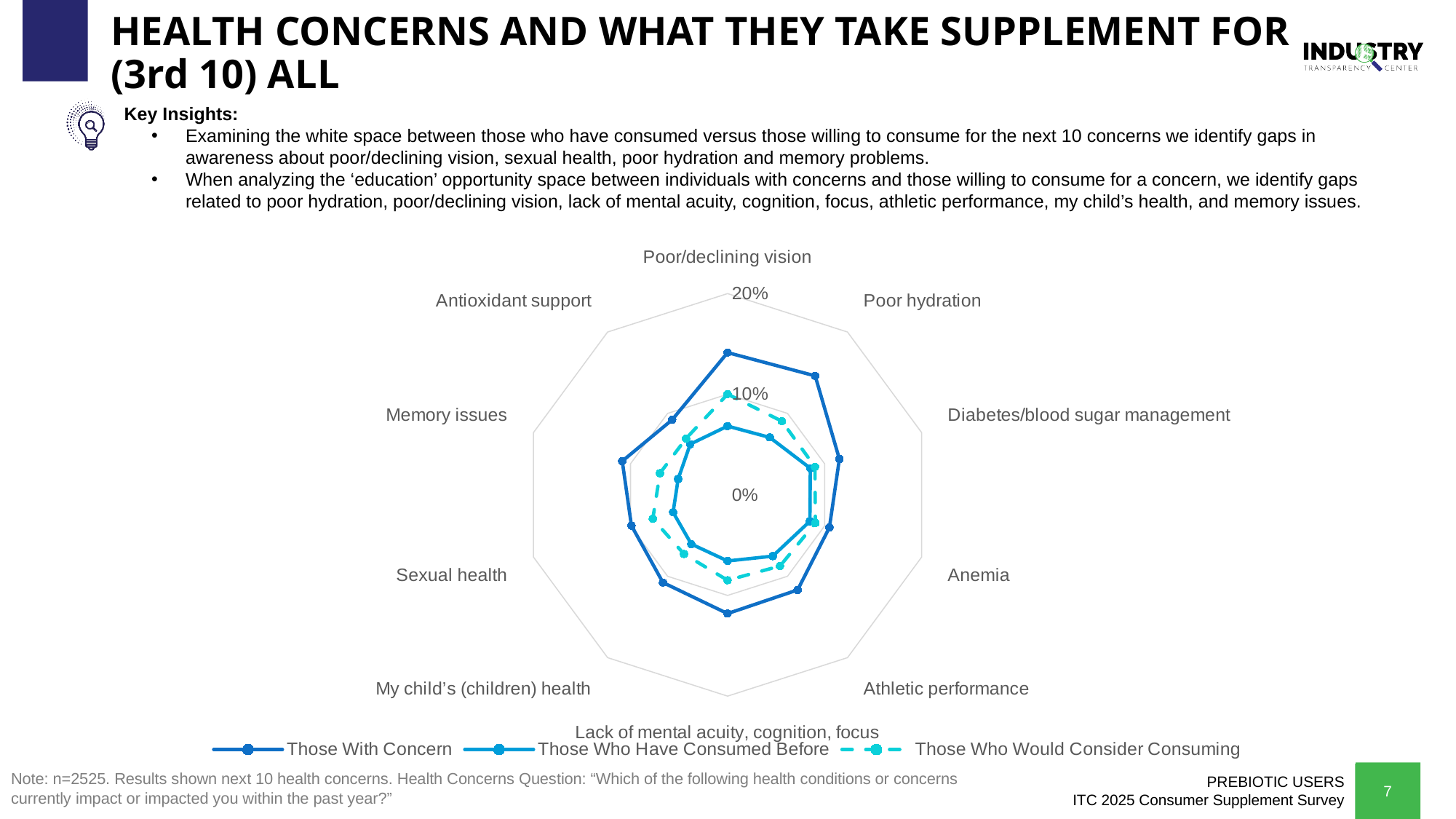
Which series is shown with a dashed line on the radar chart? Those Who Would Consider Consuming Is the value for Poor hydration in the Those With Concern series greater or less than 10%? greater What kind of chart is shown on the slide? Radar chart How many series does the legend of the radar chart list? 3 How many health concern categories are plotted on the radar chart? 10 Is the value for Athletic performance in the Those With Concern series greater or less than 10%? greater What is the highest percentage tick shown on the radar chart's axis? 20% Is the value for Poor/declining vision in the Those Who Have Consumed Before series greater or less than 10%? less For Poor/declining vision, which series has the larger value: Those With Concern or Those Who Have Consumed Before? Those With Concern For Poor/declining vision, which series has the larger value: Those Who Would Consider Consuming or Those Who Have Consumed Before? Those Who Would Consider Consuming